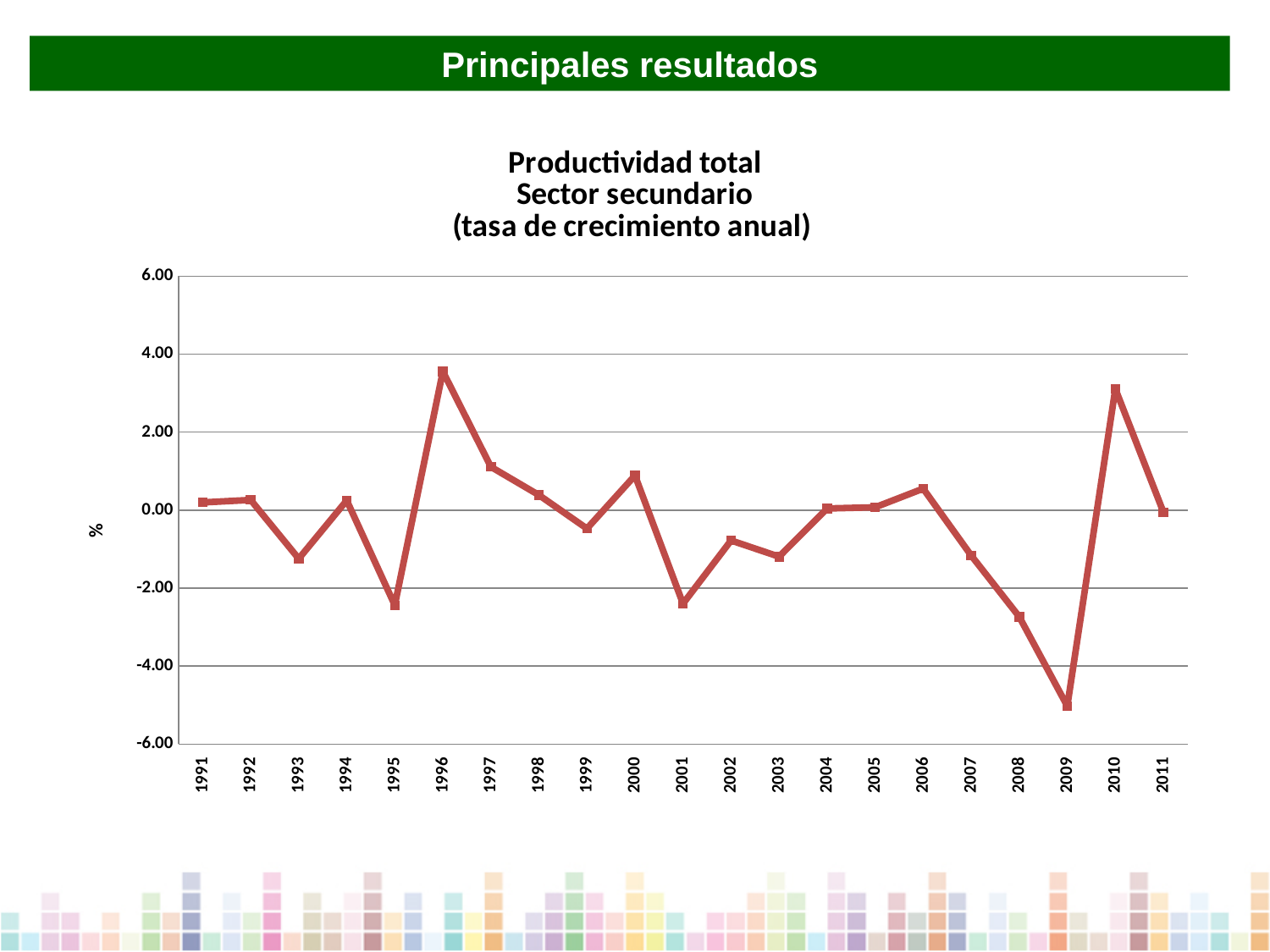
Which year has the lowest value? 2009 Is the value for 2001 greater or less than -2.00? less Which year has the larger value, 2000 or 2001? 2000 Which year has the larger value, 2007 or 2008? 2007 Which year has the highest value? 1996 Is the value for 2009 greater or less than -4.00? less How many years are plotted along the x axis? 21 Do the values rise or fall from 2006 to 2009? fall What kind of chart is shown on the slide? line chart What is the label on the y axis? % Is the value for 2010 greater or less than 2.00? greater